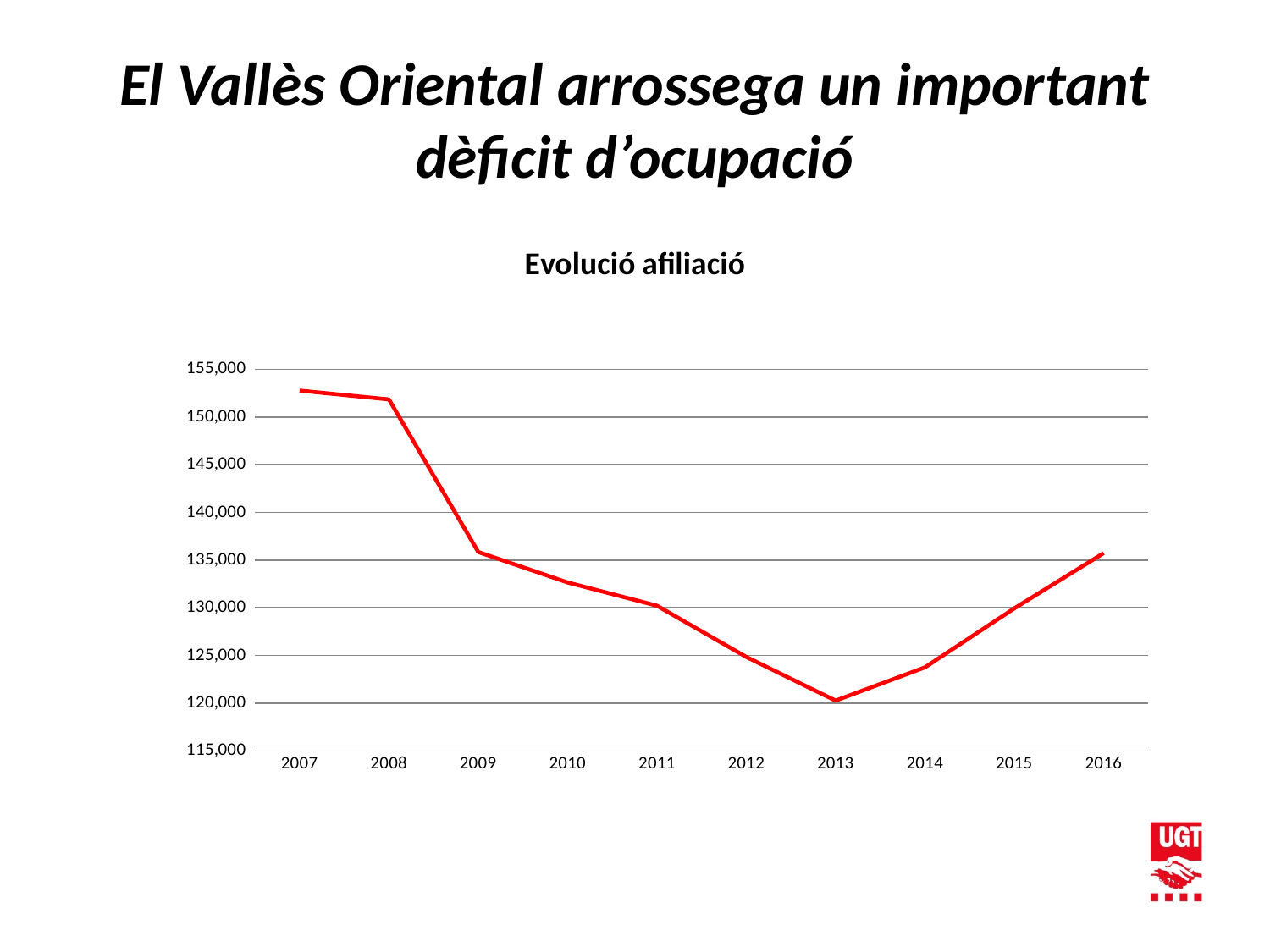
Which year has the lowest value in the chart? 2013 Which year has the highest value in the chart? 2007 How many years are plotted on the x axis of the chart? 10 Do the values rise or fall from 2013 to 2016? rise Do the values rise or fall from 2007 to 2013? fall Is the value for 2010 greater or less than 130,000? greater Is the value for 2013 greater or less than 125,000? less What kind of chart is shown on the slide? line chart Is the value for 2016 greater or less than 130,000? greater Which is larger, the value for 2007 or the value for 2016? 2007 What is the title of the chart? Evolució afiliació